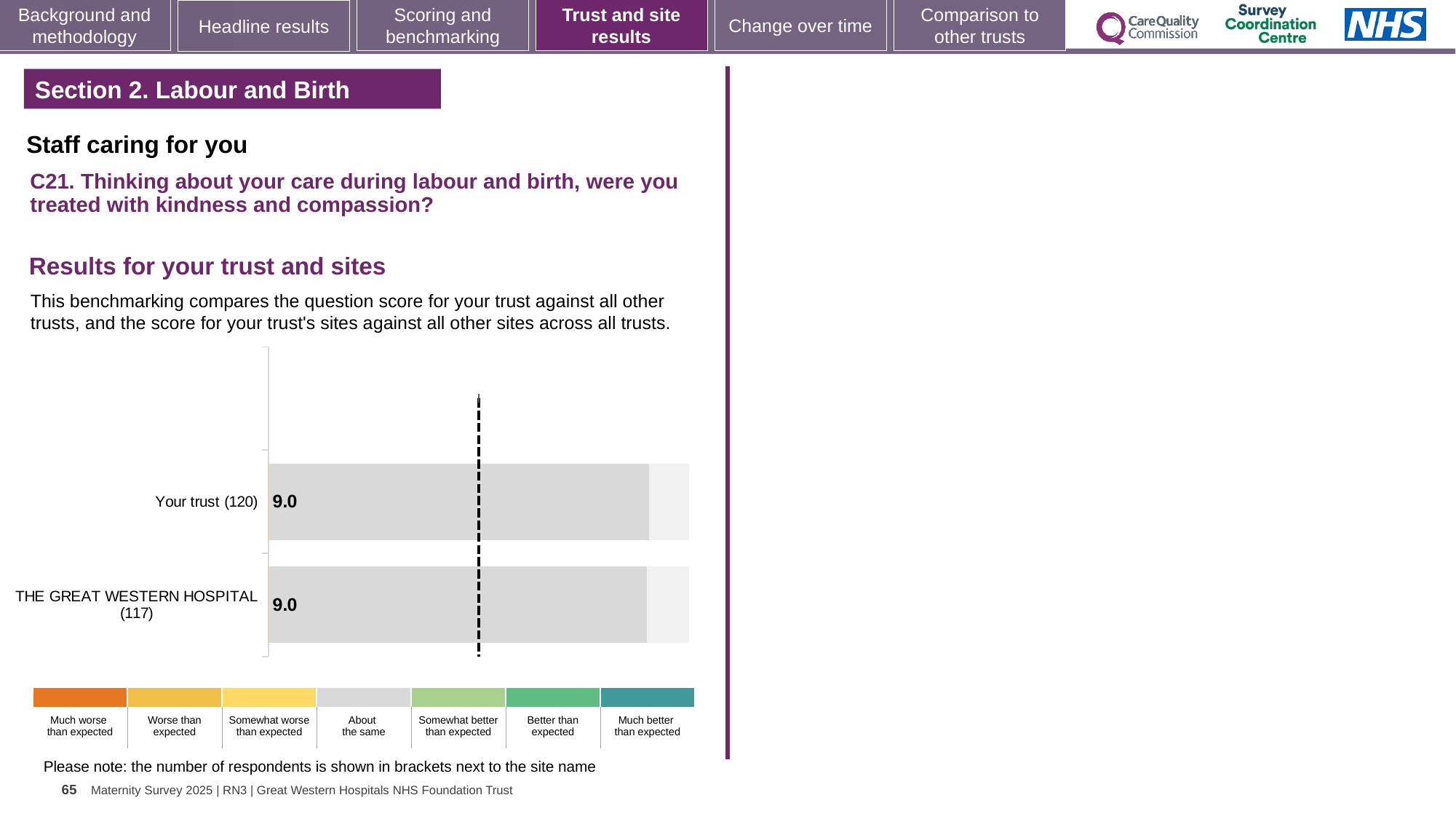
How many bars are plotted in the chart? 2 What is the score for Your trust (120)? 9.0 How many respondents are shown in brackets for Your trust? 120 Which category in the colour key does the grey colour of the bars correspond to? About the same How many categories does the colour key below the chart list? 7 Which survey question does the chart relate to? C21. Thinking about your care during labour and birth, were you treated with kindness and compassion? What is the difference between the score for Your trust (120) and the score for THE GREAT WESTERN HOSPITAL (117)? 0.0 How many respondents are shown in brackets for THE GREAT WESTERN HOSPITAL? 117 What kind of chart is shown on the slide? Bar chart What is the score for THE GREAT WESTERN HOSPITAL (117)? 9.0